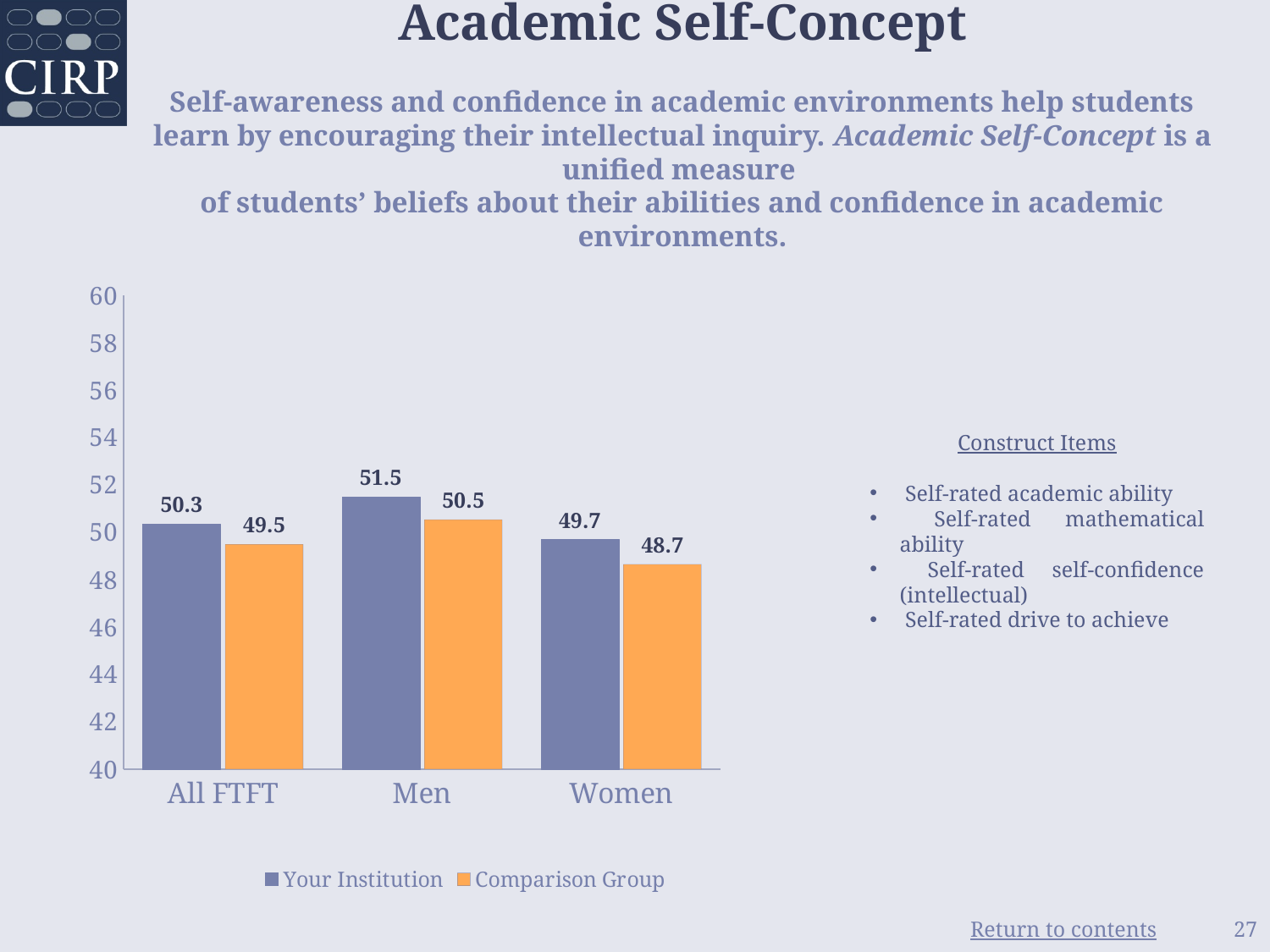
What kind of chart is shown on the slide? bar chart What is the value for Comparison Group in the Women category? 48.7 Which category has the highest value for Your Institution? Men How many categories are shown on the x axis? 3 Is the value for Your Institution in the Men category greater or less than 50? greater What is the value for Your Institution in the All FTFT category? 50.3 How many series does the legend list? 2 What colour are the Comparison Group bars? orange Which is larger in the Women category, Your Institution or Comparison Group? Your Institution What is the difference between Your Institution and Comparison Group in the Men category? 1.0 Which category has the lowest value for Comparison Group? Women What is the value for Comparison Group in the Men category? 50.5